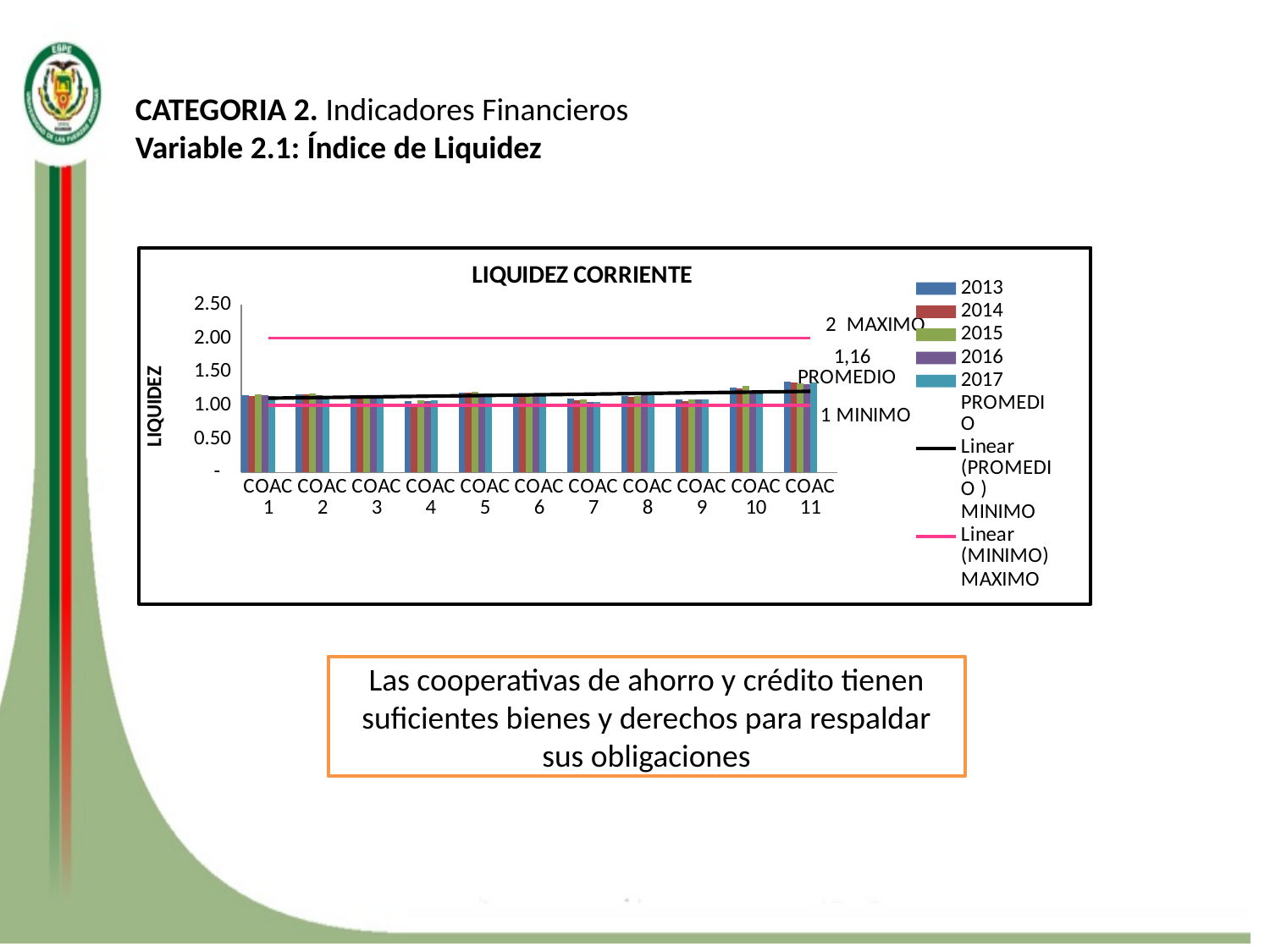
Which COAC has the highest liquidity bars in the chart? COAC 11 What is the title of the chart? LIQUIDEZ CORRIENTE What value is annotated for the MAXIMO line in the chart? 2 Is the 2017 value for COAC 1 greater or less than 2.00? less Which is larger, the 2013 value for COAC 10 or the 2013 value for COAC 4? COAC 10 How many COAC categories are shown on the x axis of the chart? 11 What type of chart is shown on the slide? bar chart What value is annotated for the PROMEDIO in the chart? 1,16 Is the 2013 value for COAC 11 greater or less than 1.00? greater Does the Linear (PROMEDIO) trend line rise or fall from COAC 1 to COAC 11? rise What value is annotated for the MINIMO line in the chart? 1 What is the label of the vertical axis of the chart? LIQUIDEZ